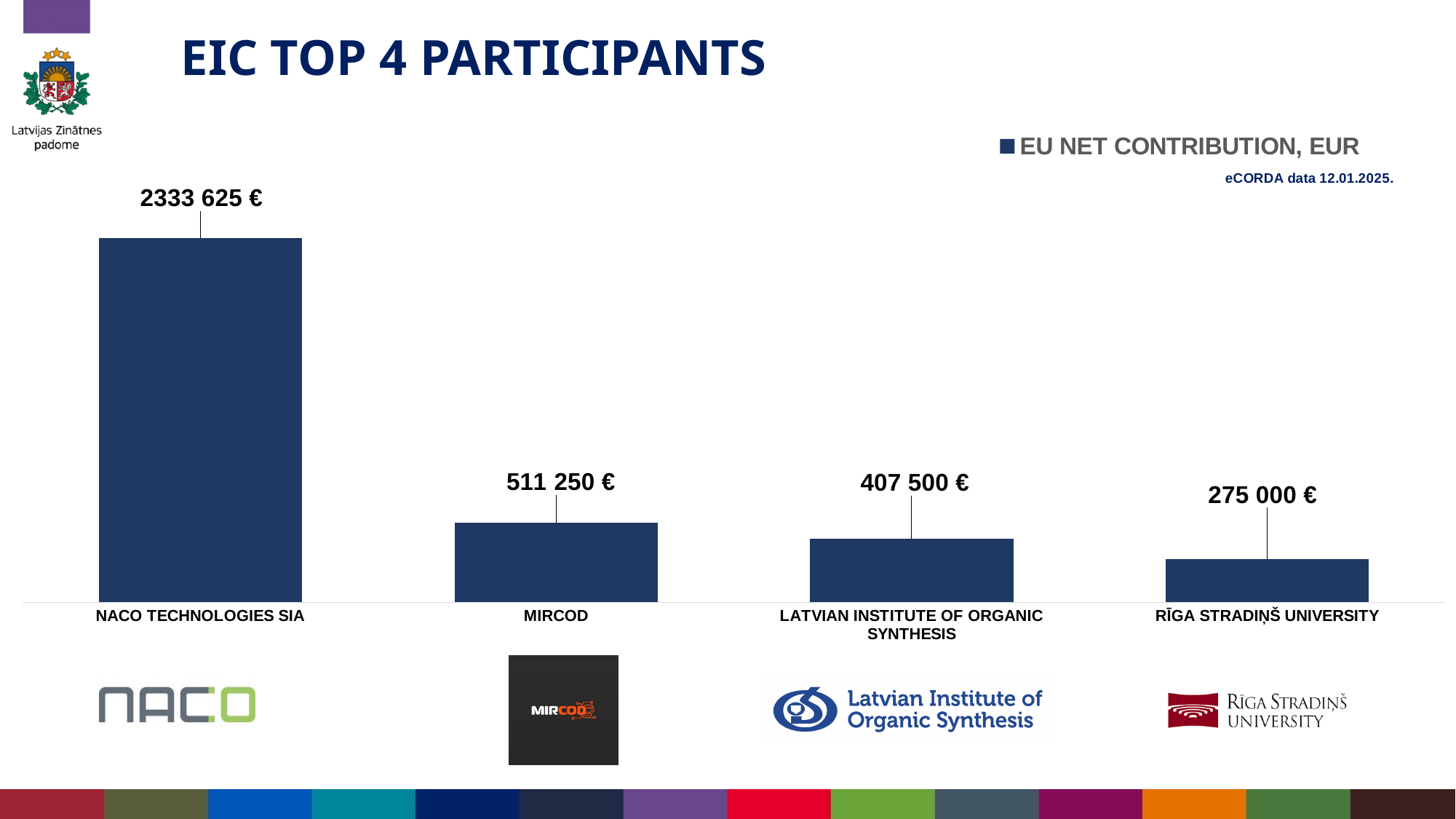
What is the EU net contribution for RĪGA STRADIŅŠ UNIVERSITY? 275 000 € What series does the chart legend list? EU NET CONTRIBUTION, EUR Which has a larger EU net contribution, MIRCOD or RĪGA STRADIŅŠ UNIVERSITY? MIRCOD How many participants are shown in the chart? 4 What is the difference between the EU net contributions of MIRCOD and LATVIAN INSTITUTE OF ORGANIC SYNTHESIS? 103 750 € What kind of chart is shown on the slide? Bar chart What is the difference between the EU net contributions of LATVIAN INSTITUTE OF ORGANIC SYNTHESIS and RĪGA STRADIŅŠ UNIVERSITY? 132 500 € Which participant has the highest EU net contribution? NACO TECHNOLOGIES SIA What is the EU net contribution for MIRCOD? 511 250 € Which participant has the lowest EU net contribution? RĪGA STRADIŅŠ UNIVERSITY What is the EU net contribution for NACO TECHNOLOGIES SIA? 2333 625 € What is the EU net contribution for LATVIAN INSTITUTE OF ORGANIC SYNTHESIS? 407 500 €